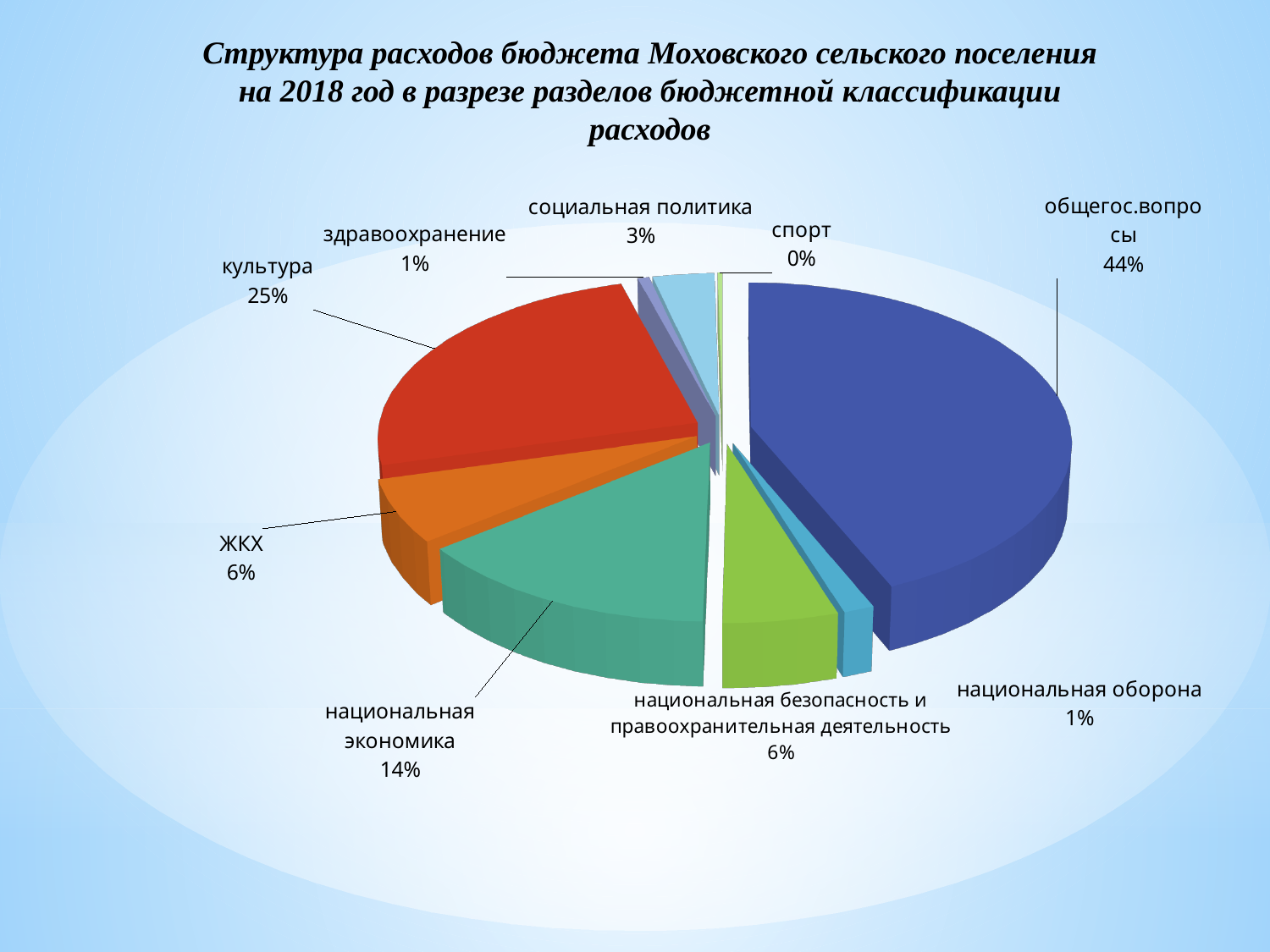
What is the difference in percentage points between общегос.вопросы and культура? 19 What kind of chart is shown on the slide? pie chart What share of the pie does общегос.вопросы have? 44% What is the value shown for национальная экономика? 14% Which is larger, the share for национальная экономика or the share for ЖКХ? национальная экономика What share of the pie does культура have? 25% Which category has the smallest share of the pie? спорт What is the value shown for спорт? 0% What colour is the slice for культура? red What is the value shown for социальная политика? 3% How many categories are shown in the pie chart? 9 Which category has the largest share of the pie? общегос.вопросы